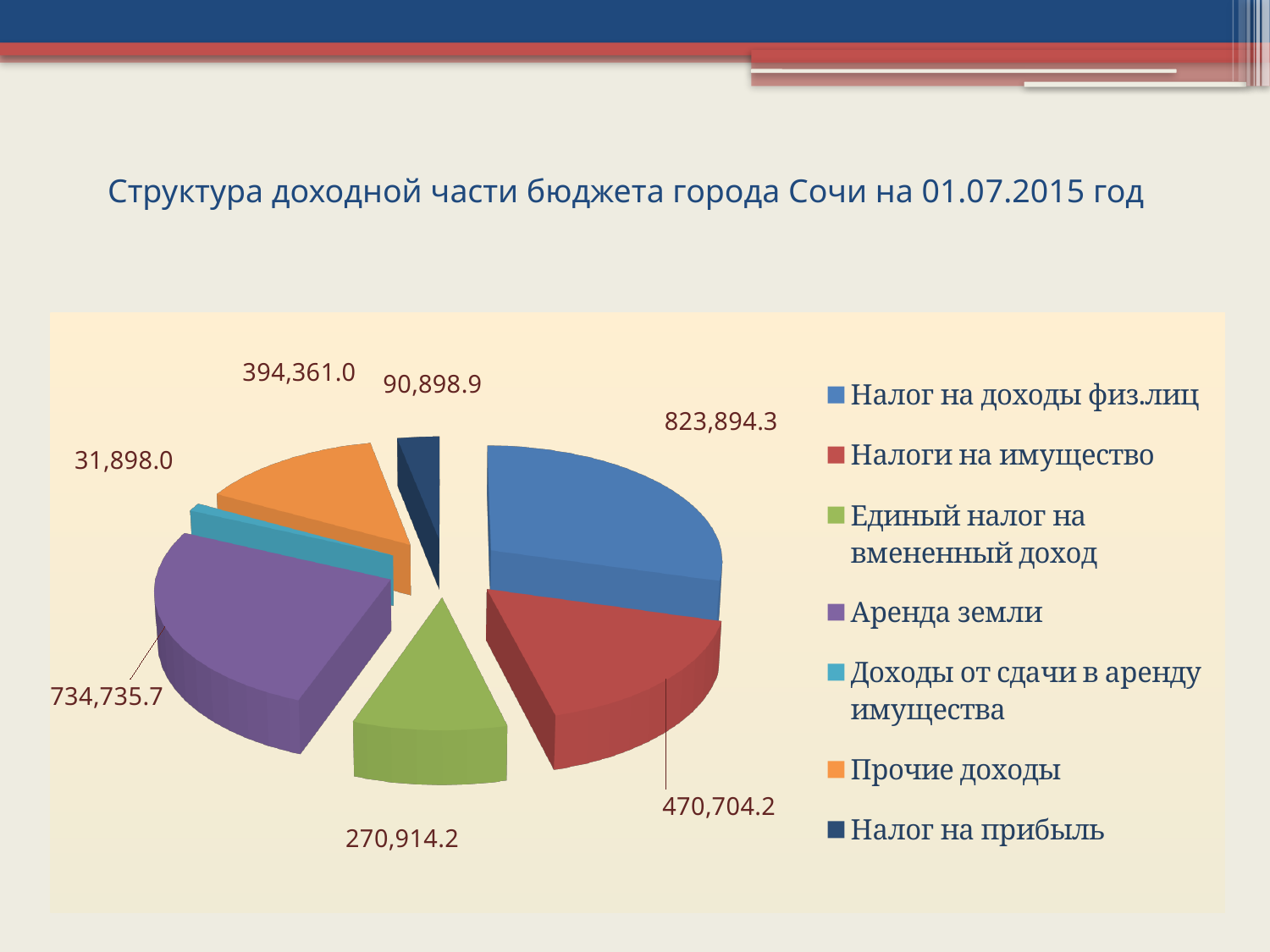
Which category has the largest value? Налог на доходы физ.лиц What is the difference between Налог на доходы физ.лиц and Аренда земли? 89,158.6 Which category has the smallest value? Доходы от сдачи в аренду имущества What is the difference between Налоги на имущество and Единый налог на вмененный доход? 199,790.0 What is the value for Прочие доходы? 394,361.0 What is the value for Аренда земли? 734,735.7 What colour is the slice for Аренда земли? Purple What type of chart is shown on the slide? Pie chart What is the value for Доходы от сдачи в аренду имущества? 31,898.0 How many categories does the legend list? 7 Which is larger, Прочие доходы or Налог на прибыль? Прочие доходы What is the value for Налог на доходы физ.лиц? 823,894.3